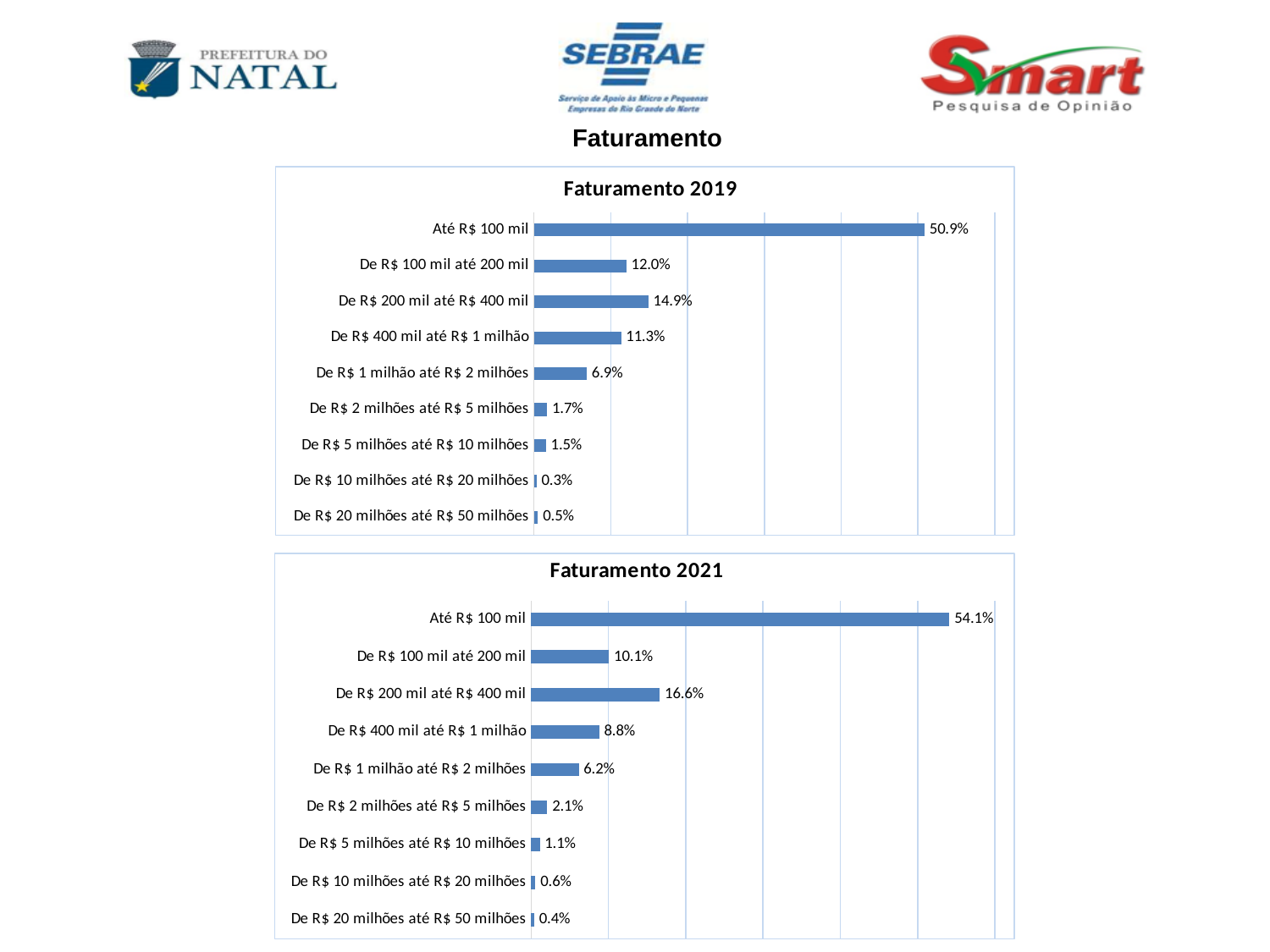
In the Faturamento 2019 chart, what is the difference between De R$ 200 mil até R$ 400 mil and De R$ 100 mil até 200 mil? 2.9% In the Faturamento 2021 chart, which is larger: De R$ 2 milhões até R$ 5 milhões or De R$ 5 milhões até R$ 10 milhões? De R$ 2 milhões até R$ 5 milhões In the Faturamento 2021 chart, which category has the highest value? Até R$ 100 mil In the Faturamento 2021 chart, what is the difference between Até R$ 100 mil and De R$ 100 mil até 200 mil? 44.0% In the Faturamento 2019 chart, which is larger: De R$ 400 mil até R$ 1 milhão or De R$ 1 milhão até R$ 2 milhões? De R$ 400 mil até R$ 1 milhão What is the title of the top chart on the slide? Faturamento 2019 In the Faturamento 2019 chart, which category has the lowest value? De R$ 10 milhões até R$ 20 milhões In the Faturamento 2021 chart, what is the value for De R$ 200 mil até R$ 400 mil? 16.6% In the Faturamento 2019 chart, what is the value for Até R$ 100 mil? 50.9% How many categories does the Faturamento 2019 chart show? 9 What kind of chart is the Faturamento 2021 chart? Bar chart In the Faturamento 2021 chart, which category has the lowest value? De R$ 20 milhões até R$ 50 milhões